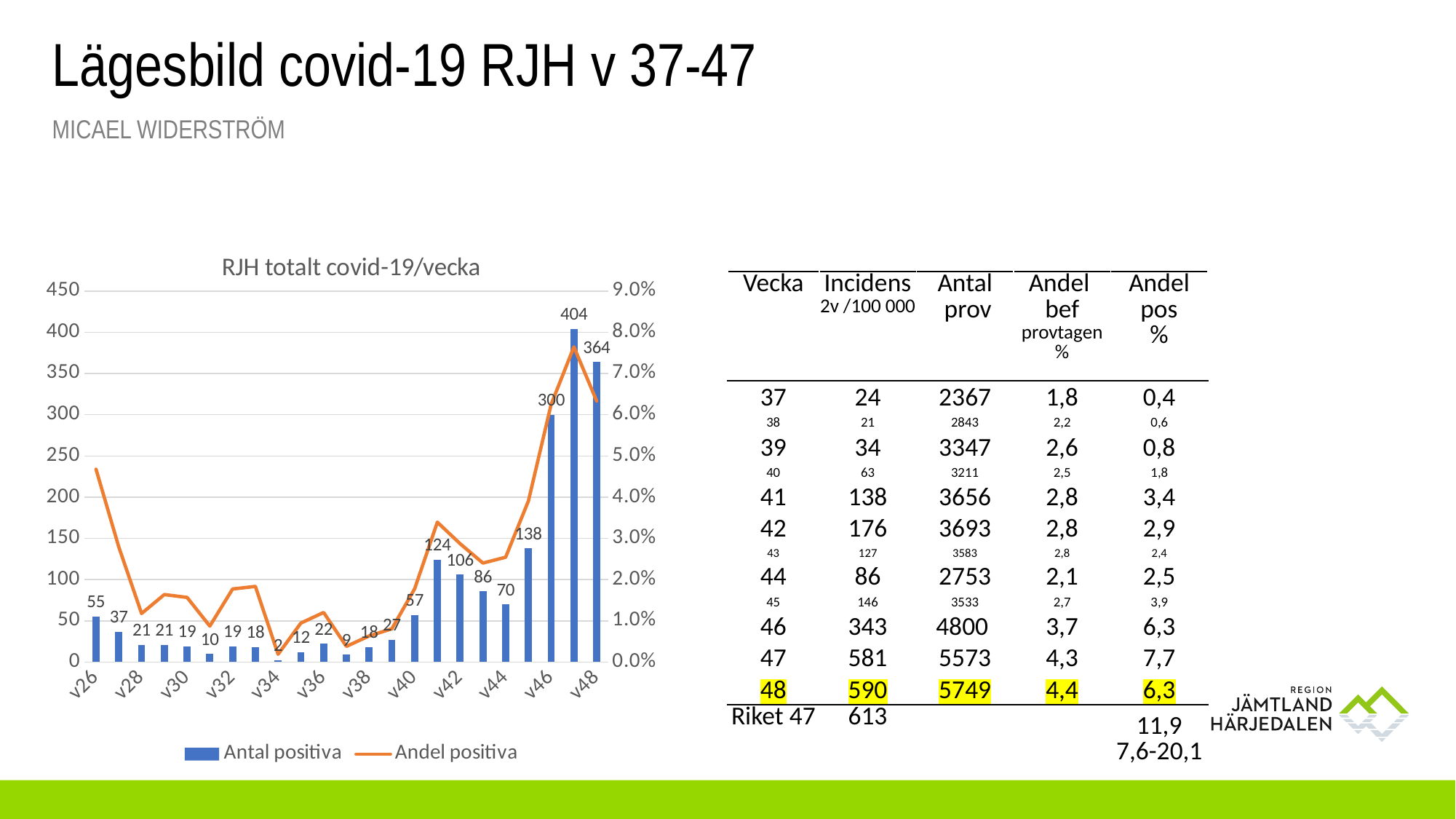
Does Antal positiva rise or fall from v40 to v46? rise What is the value of Antal positiva for v26? 55 How many series does the chart legend list? 2 Which week has a larger Antal positiva value, v42 or v44? v42 What is the difference in Antal positiva between v48 and v46? 64 What kind of chart is used for the Antal positiva series? bar chart What is the title of the chart on the slide? RJH totalt covid-19/vecka Which week has the lowest value of Antal positiva? v34 What is the value of Antal positiva for v46? 300 What is the highest value of Antal positiva shown in the chart? 404 Is the Andel positiva value for v26 greater or less than 4.0%? greater What is the value of Antal positiva for v48? 364